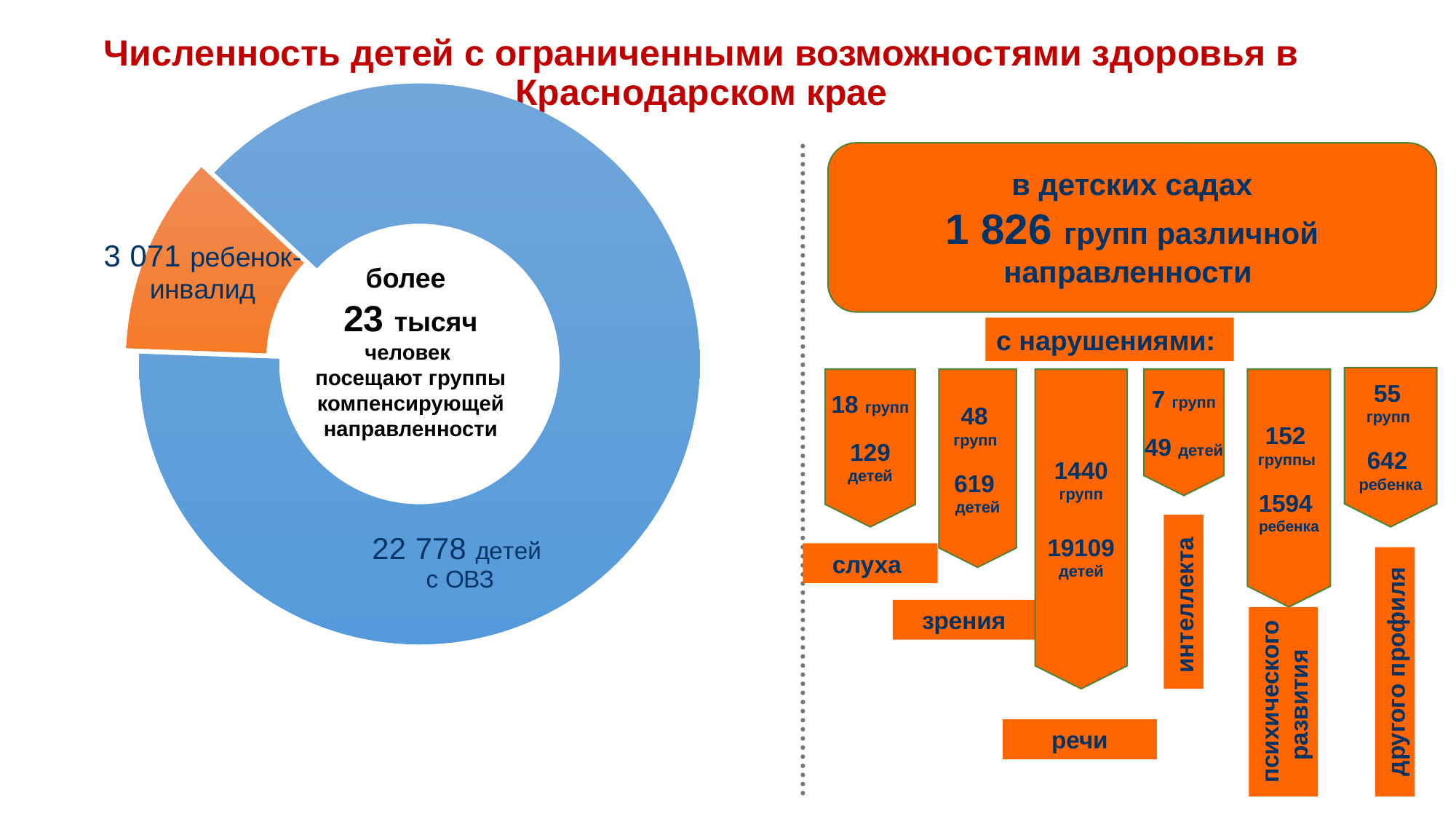
In the infographic on the right, how many групп are listed for речи? 1440 In the donut chart on the left, what colour is the ребенок-инвалид slice? orange How many slices does the donut chart on the left have? 2 In the donut chart on the left, what is the difference between the number of детей с ОВЗ and the number of ребенок-инвалид? 19 707 In the donut chart on the left, which slice is the smallest? 3 071 ребенок-инвалид What number is written in the centre of the donut chart on the left? более 23 тысяч человек In the donut chart on the left, which slice is the largest? 22 778 детей с ОВЗ In the donut chart on the left, which is larger: детей с ОВЗ or ребенок-инвалид? детей с ОВЗ In the donut chart on the left, what is the value for ребенок-инвалид? 3 071 What kind of chart is shown on the left of the slide? donut (pie) chart In the infographic on the right, how many детей are listed for слуха? 129 In the donut chart on the left, what is the value for детей с ОВЗ? 22 778